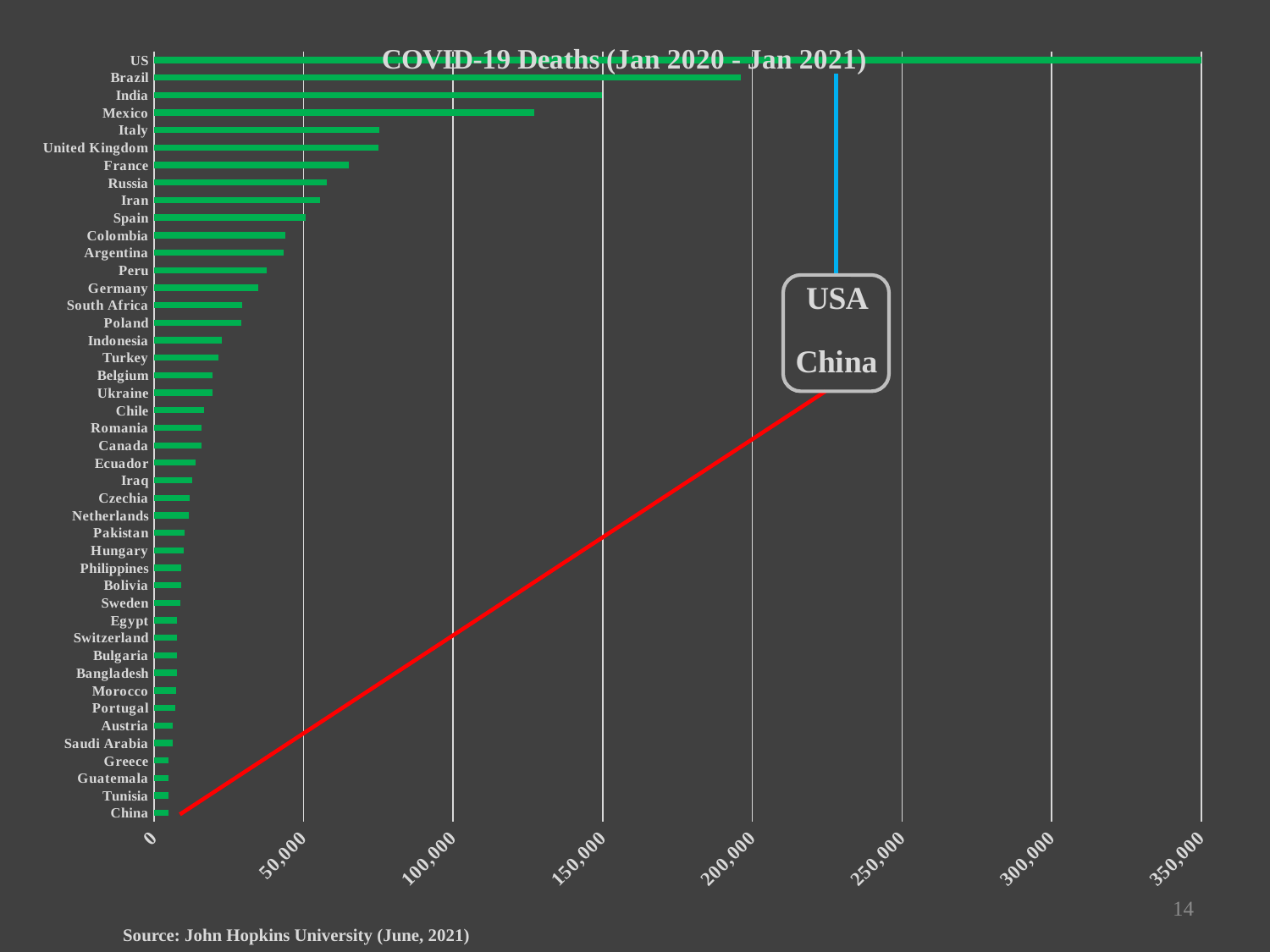
Which country has the highest number of COVID-19 deaths in the chart? US Is the value for Mexico greater or less than 100,000? greater Which country has more COVID-19 deaths, Brazil or India? Brazil Which country has the lowest number of COVID-19 deaths in the chart? China Which country has more COVID-19 deaths, Germany or Mexico? Mexico Is the value for Italy greater or less than 50,000? greater What is the title of the chart? COVID-19 Deaths (Jan 2020 - Jan 2021) What source is cited for the chart data? John Hopkins University (June, 2021) Is the value for the US greater or less than 300,000? greater What kind of chart is shown on the slide? bar chart How many countries are listed in the chart? 44